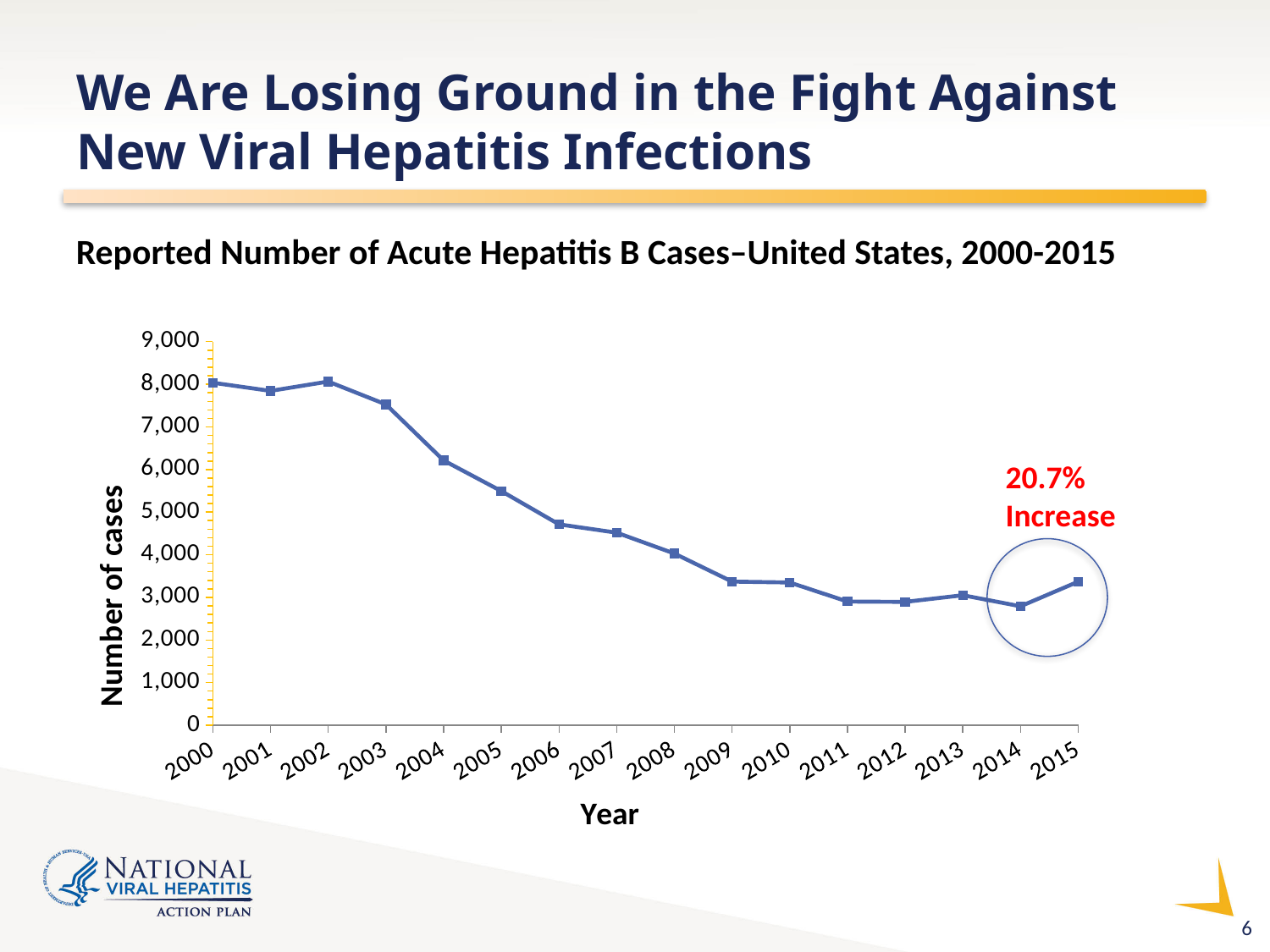
What percentage increase is annotated in red next to the circled portion of the line? 20.7% Increase What kind of chart is shown on the slide? Line chart Overall, do the reported acute hepatitis B cases rise or fall from 2000 to 2015? Fall Is the value for 2015 greater or less than 3,000? greater Which year has more reported cases, 2003 or 2004? 2003 Is the value for 2014 greater or less than 3,000? less Is the value for 2000 greater or less than 7,000? greater What is the label on the y-axis of the chart? Number of cases Which year has more reported cases, 2014 or 2015? 2015 How many years (data points) are plotted on the chart? 16 Which year has the lowest number of reported cases? 2014